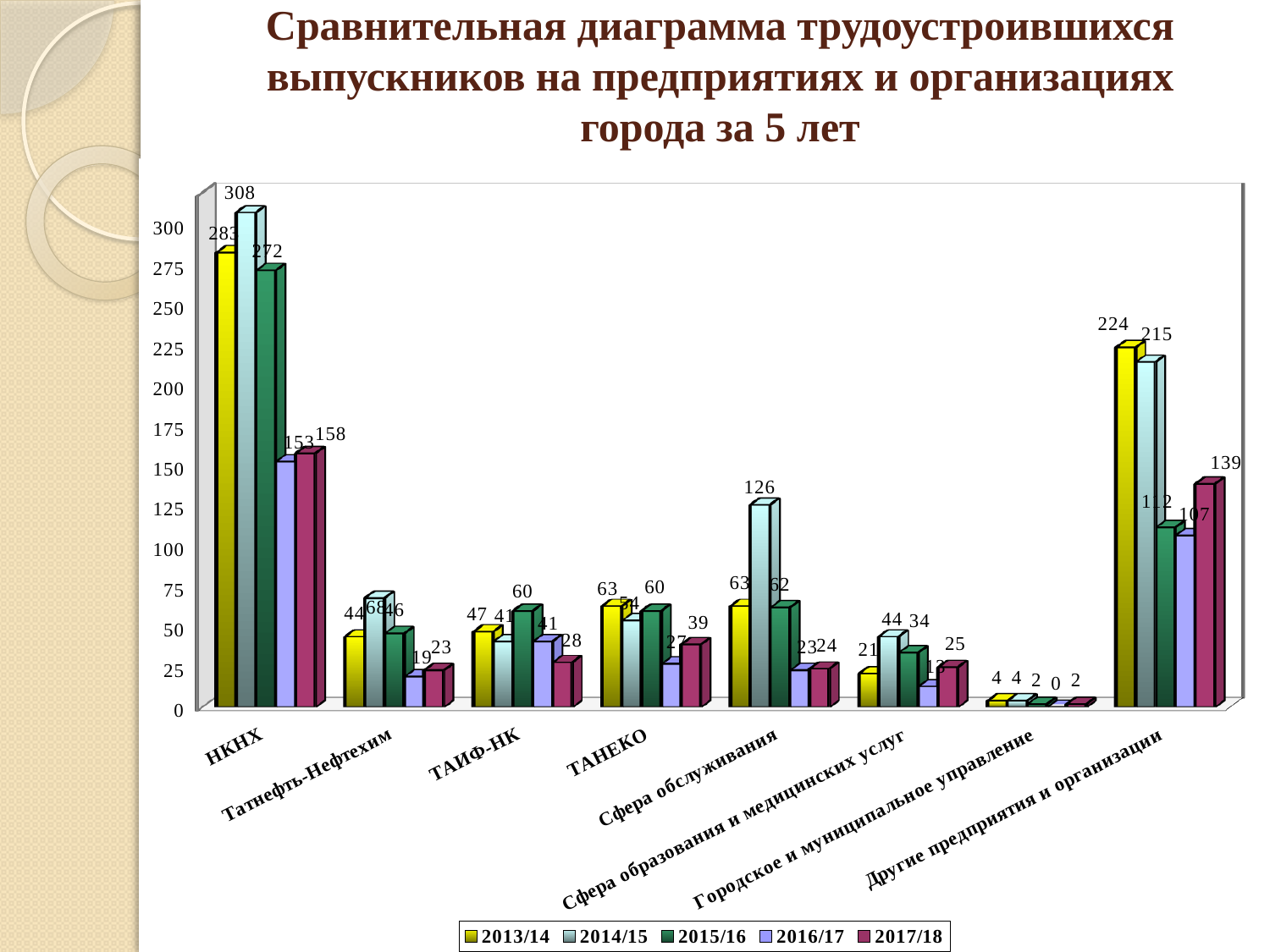
Which legend entry is shown in yellow? 2013/14 What is the value for НКНХ in 2014/15? 308 What is the difference between the 2014/15 and 2013/14 values for НКНХ? 25 Is the value for Другие предприятия и организации in 2013/14 greater or less than 200? greater How many series does the legend list? 5 What is the value for Сфера обслуживания in 2014/15? 126 What is the value for Другие предприятия и организации in 2017/18? 139 Which is larger for Татнефть-Нефтехим: the 2014/15 value or the 2015/16 value? 2014/15 Which category has the highest value in 2013/14? НКНХ What type of chart is shown on the slide? bar chart How many categories are shown on the x axis? 8 Which category has the lowest value in 2016/17? Городское и муниципальное управление